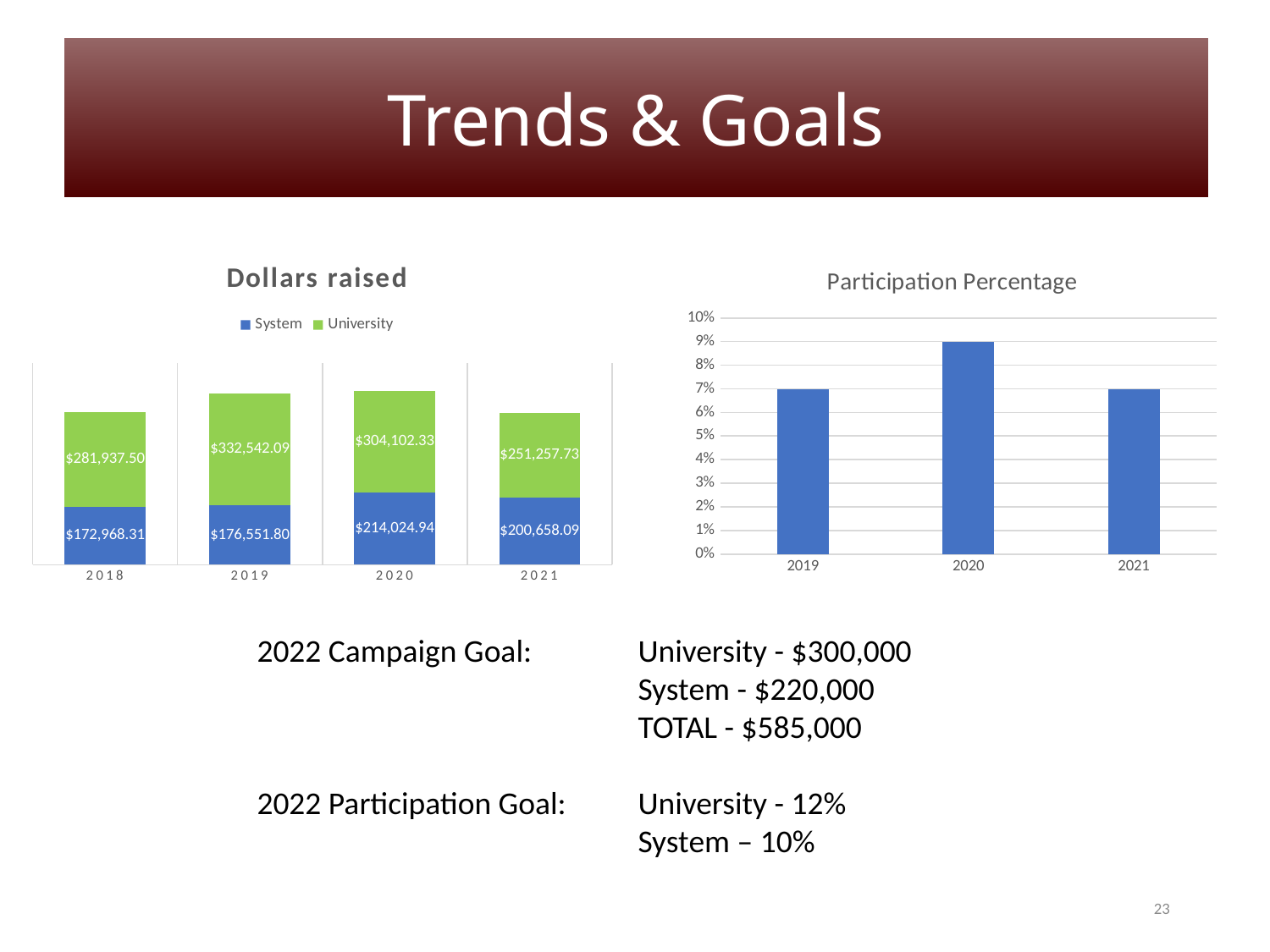
In the Dollars raised chart, which year has the lowest System value? 2018 In the Dollars raised chart, is the System value larger in 2020 or in 2021? 2020 In the Dollars raised chart, what is the difference between the University values for 2019 and 2018? $50,604.59 How many series does the legend of the Dollars raised chart list? 2 How many years are shown on the x axis of the Participation Percentage chart? 3 In the Participation Percentage chart, what is the value for 2020? 9% In the Dollars raised chart, which year has the highest University value? 2019 What kind of chart is the Participation Percentage chart? Bar chart In the Dollars raised chart, what is the University value for 2019? $332,542.09 In the Participation Percentage chart, which year has the highest value? 2020 In the Dollars raised chart, what is the System value for 2020? $214,024.94 In the Dollars raised chart, what is the total of the stacked bar for 2020? $518,127.27